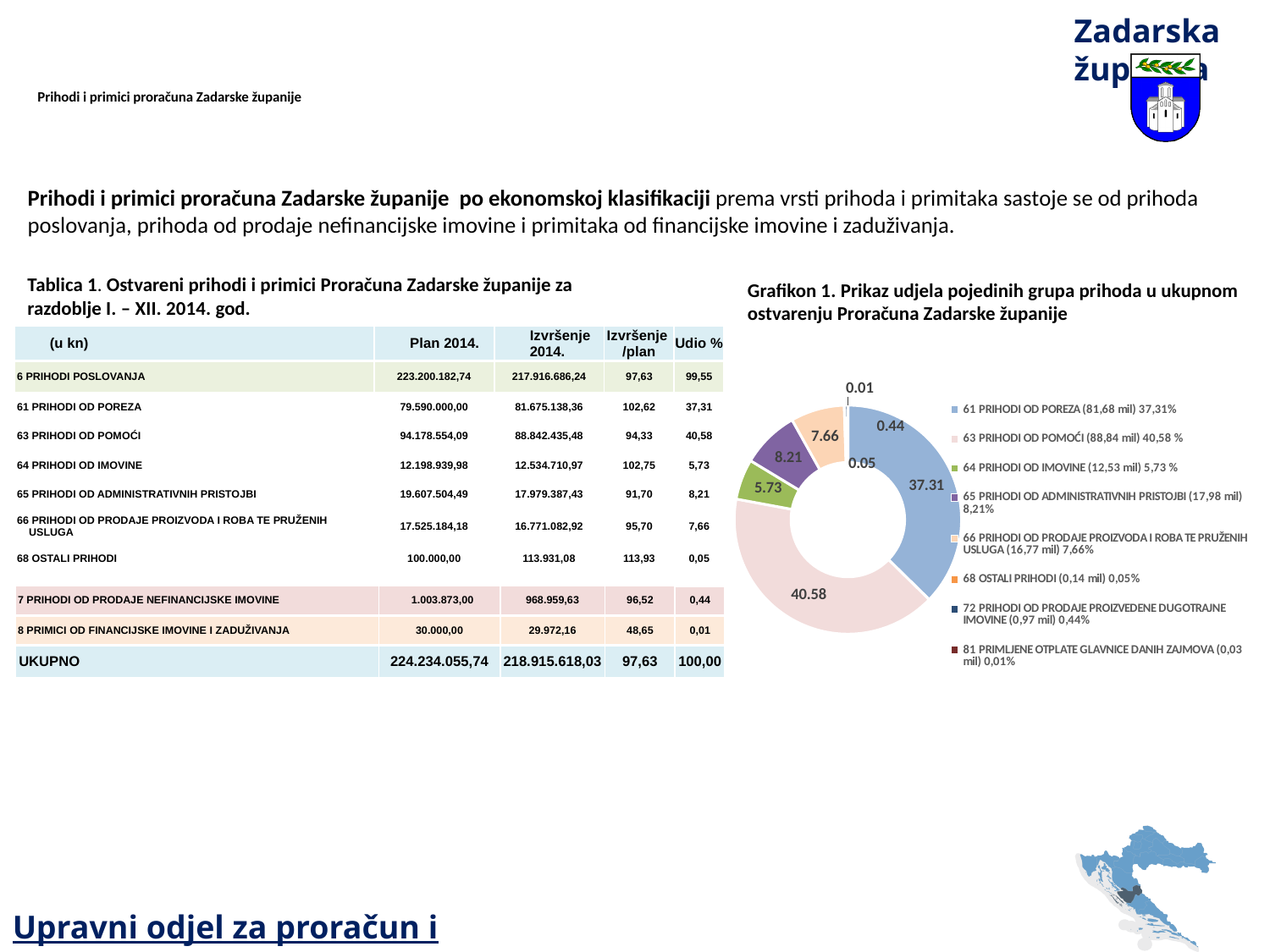
How many entries does the legend of Grafikon 1 list? 8 In Grafikon 1, what is the data label for 64 PRIHODI OD IMOVINE? 5.73 In Grafikon 1, which is larger: the slice for 65 PRIHODI OD ADMINISTRATIVNIH PRISTOJBI or the slice for 64 PRIHODI OD IMOVINE? 65 PRIHODI OD ADMINISTRATIVNIH PRISTOJBI In Grafikon 1, what is the data label for 61 PRIHODI OD POREZA? 37.31 In Grafikon 1, which category has the largest slice? 63 PRIHODI OD POMOĆI In Grafikon 1, what is the data label for 65 PRIHODI OD ADMINISTRATIVNIH PRISTOJBI? 8.21 In Grafikon 1, what is the data label for 63 PRIHODI OD POMOĆI? 40.58 What kind of chart is Grafikon 1? doughnut chart In Grafikon 1, what is the data label for 66 PRIHODI OD PRODAJE PROIZVODA I ROBA TE PRUŽENIH USLUGA? 7.66 In Grafikon 1, what is the difference between the data labels for 63 PRIHODI OD POMOĆI and 61 PRIHODI OD POREZA? 3.27 What is the title of the chart on the slide? Grafikon 1. Prikaz udjela pojedinih grupa prihoda u ukupnom ostvarenju Proračuna Zadarske županije In Grafikon 1, which category has the smallest slice? 81 PRIMLJENE OTPLATE GLAVNICE DANIH ZAJMOVA